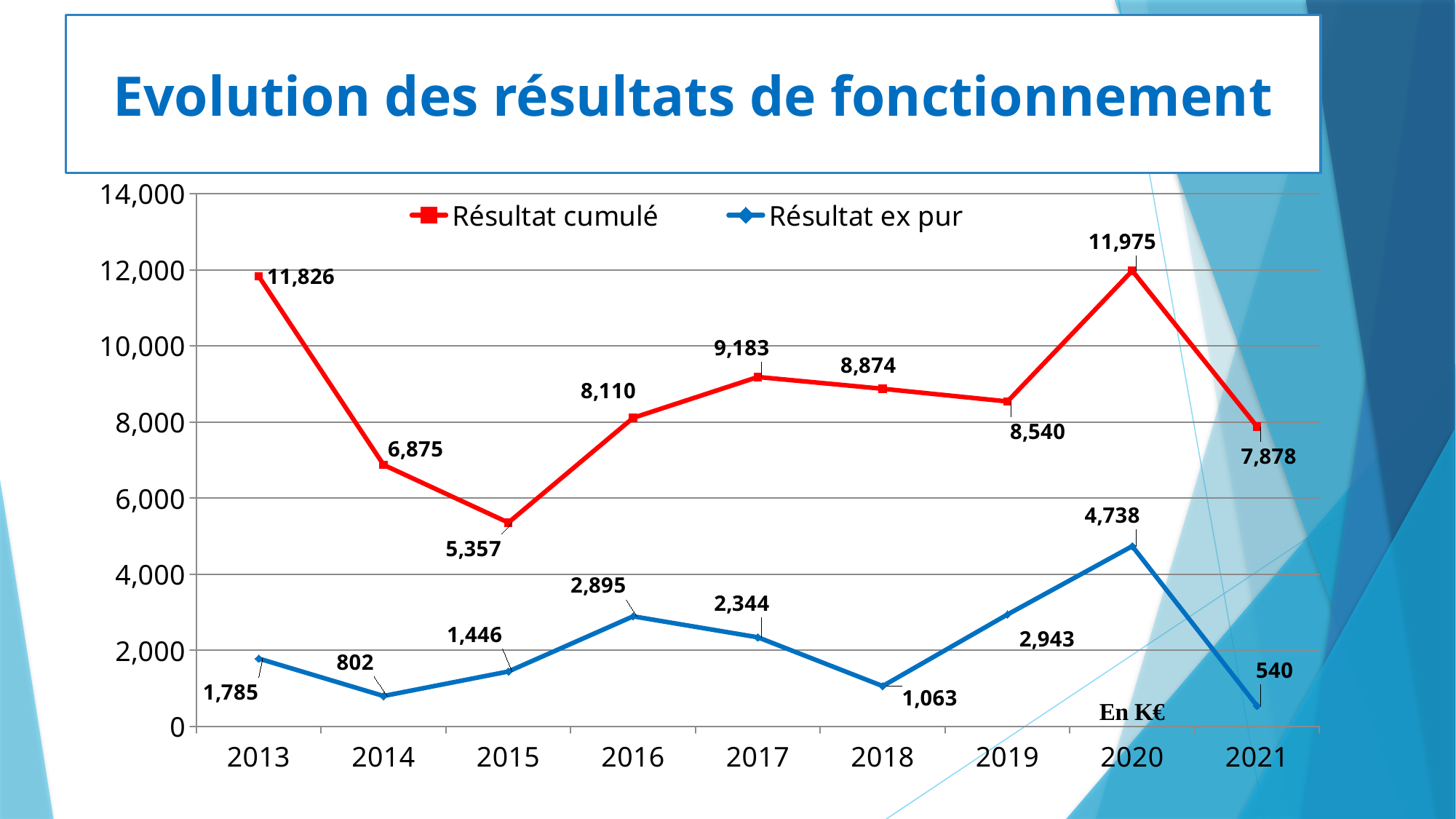
What kind of chart is shown on the slide? Line chart In which year is Résultat ex pur highest? 2020 Which is larger: Résultat ex pur in 2019 or Résultat ex pur in 2017? Résultat ex pur in 2019 What is the value of Résultat cumulé in 2020? 11,975 What is the value of Résultat ex pur in 2016? 2,895 What unit is indicated on the chart? En K€ How many series does the legend list? 2 In which year is Résultat cumulé lowest? 2015 In which year is Résultat ex pur lowest? 2021 What is the value of Résultat cumulé in 2015? 5,357 What is the difference between Résultat cumulé and Résultat ex pur in 2021? 7,338 How many years are shown on the x axis? 9